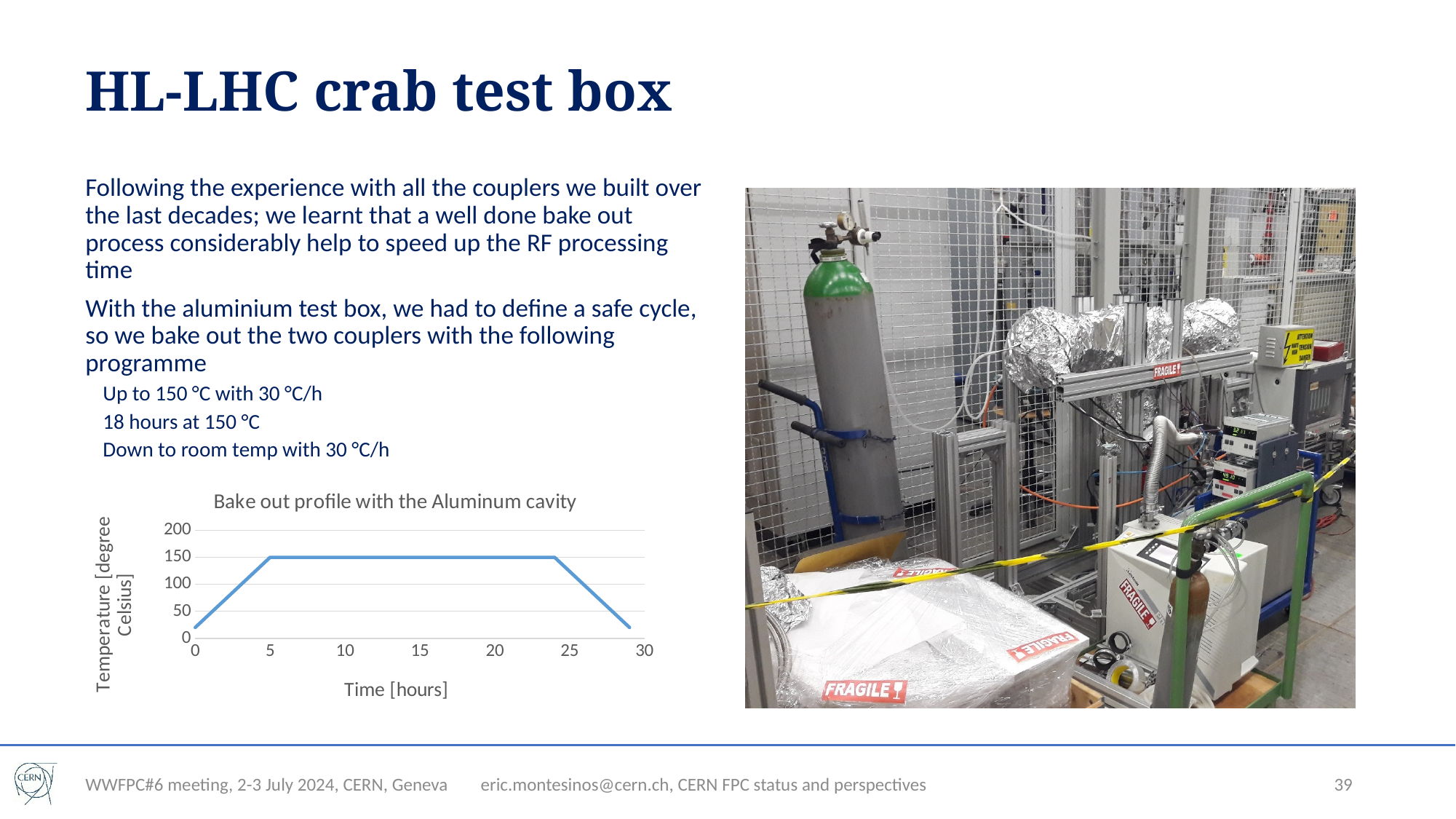
Is the temperature at the end of the profile (around 29 hours) greater or less than 50? less Which is larger, the temperature at 15 hours or the temperature at 0 hours? 15 hours Is the temperature at 10 hours greater or less than 200? less What is the title of the chart? Bake out profile with the Aluminum cavity Is the temperature at 15 hours greater or less than 100? greater What is the label of the x axis of the chart? Time [hours] Does the temperature rise or fall between 0 and 5 hours? rise What is the maximum value shown on the y axis of the chart? 200 Does the temperature rise or fall between 25 and 30 hours? fall What is the highest temperature reached on the plotted profile? 150 What kind of chart is shown on the slide? line chart